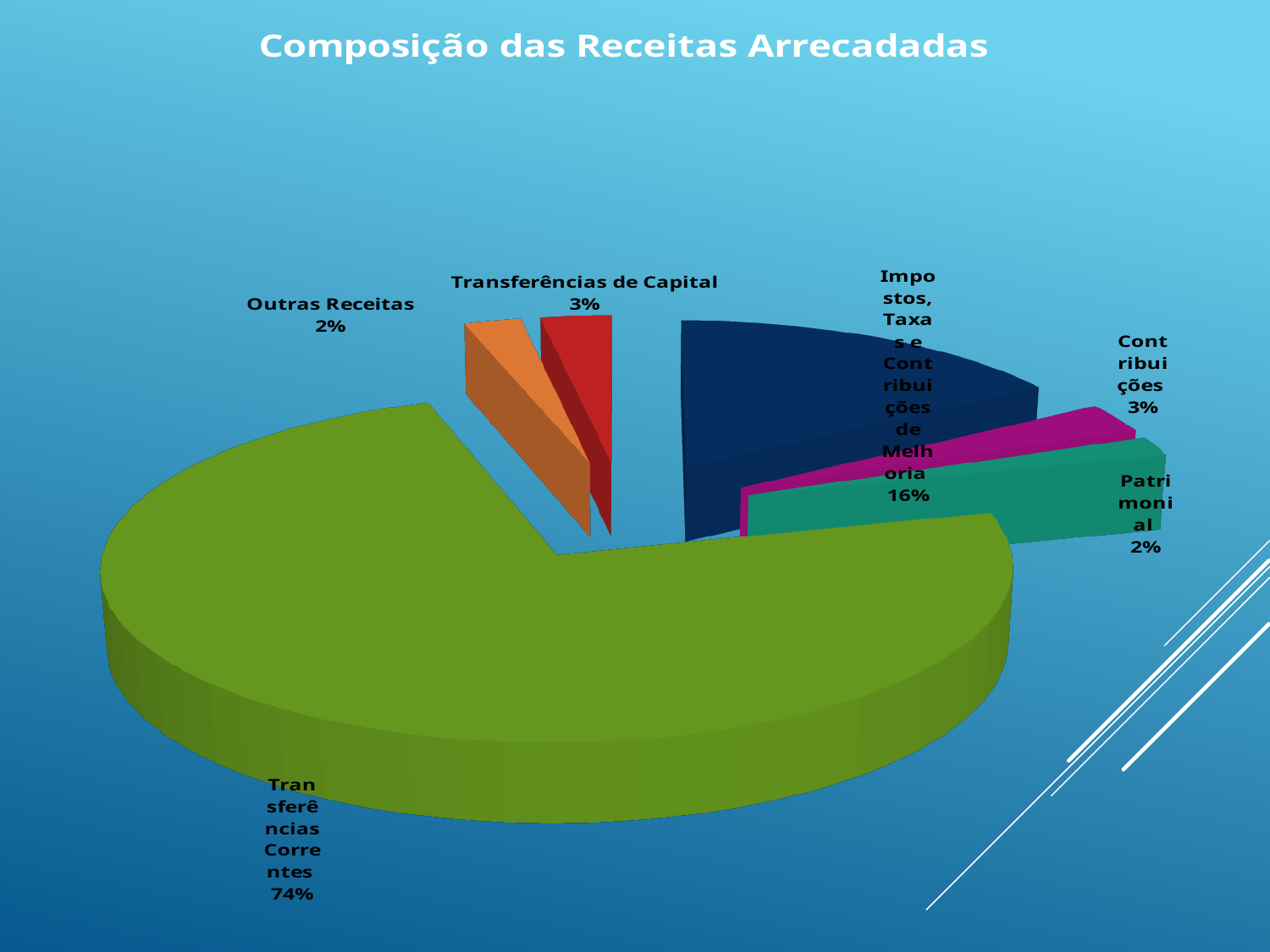
What is the value shown for Outras Receitas? 2% What share of the pie does Transferências Correntes represent? 74% Which category has the largest slice of the pie? Transferências Correntes What is the difference between the shares of Transferências Correntes and Impostos, Taxas e Contribuições de Melhoria? 58% Which is larger, the share for Contribuições or the share for Patrimonial? Contribuições What is the value shown for Patrimonial? 2% What share of the pie does Impostos, Taxas e Contribuições de Melhoria represent? 16% How many slices does the pie chart have? 6 What is the value shown for Transferências de Capital? 3% What kind of chart is shown on the slide? Pie chart What colour is the Transferências Correntes slice? Green What is the title of the chart? Composição das Receitas Arrecadadas